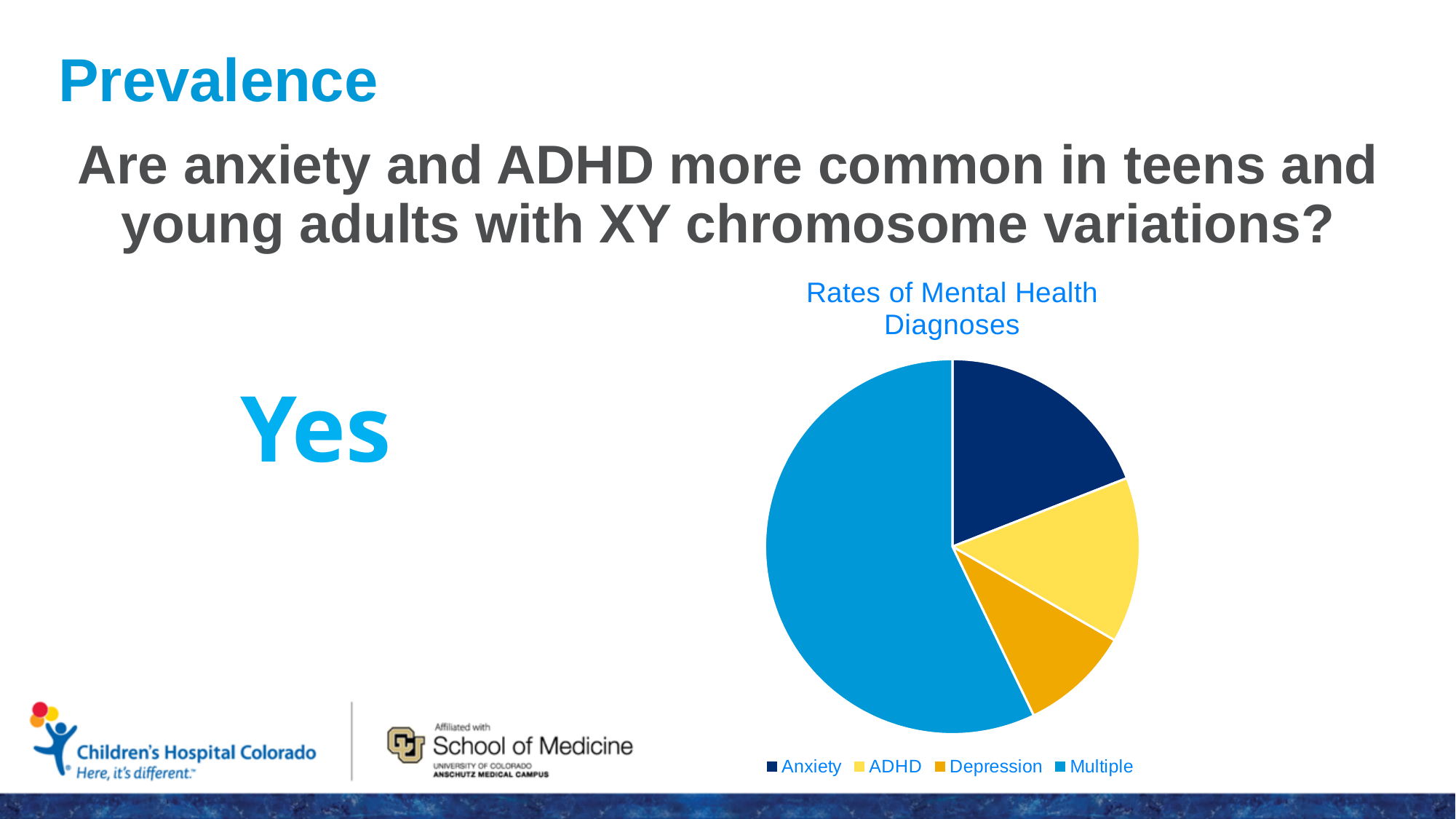
Which slice is larger, Multiple or Anxiety? Multiple How many categories does the pie chart show? 4 Which category is shown in the dark navy colour? Anxiety Does the Multiple slice take up more or less than half of the pie? More Which category has the largest slice of the pie? Multiple What is the title of the chart? Rates of Mental Health Diagnoses Which slice is larger, Multiple or ADHD? Multiple What kind of chart is shown on the slide? Pie chart Which slice is larger, ADHD or Depression? ADHD Which category has the smallest slice of the pie? Depression